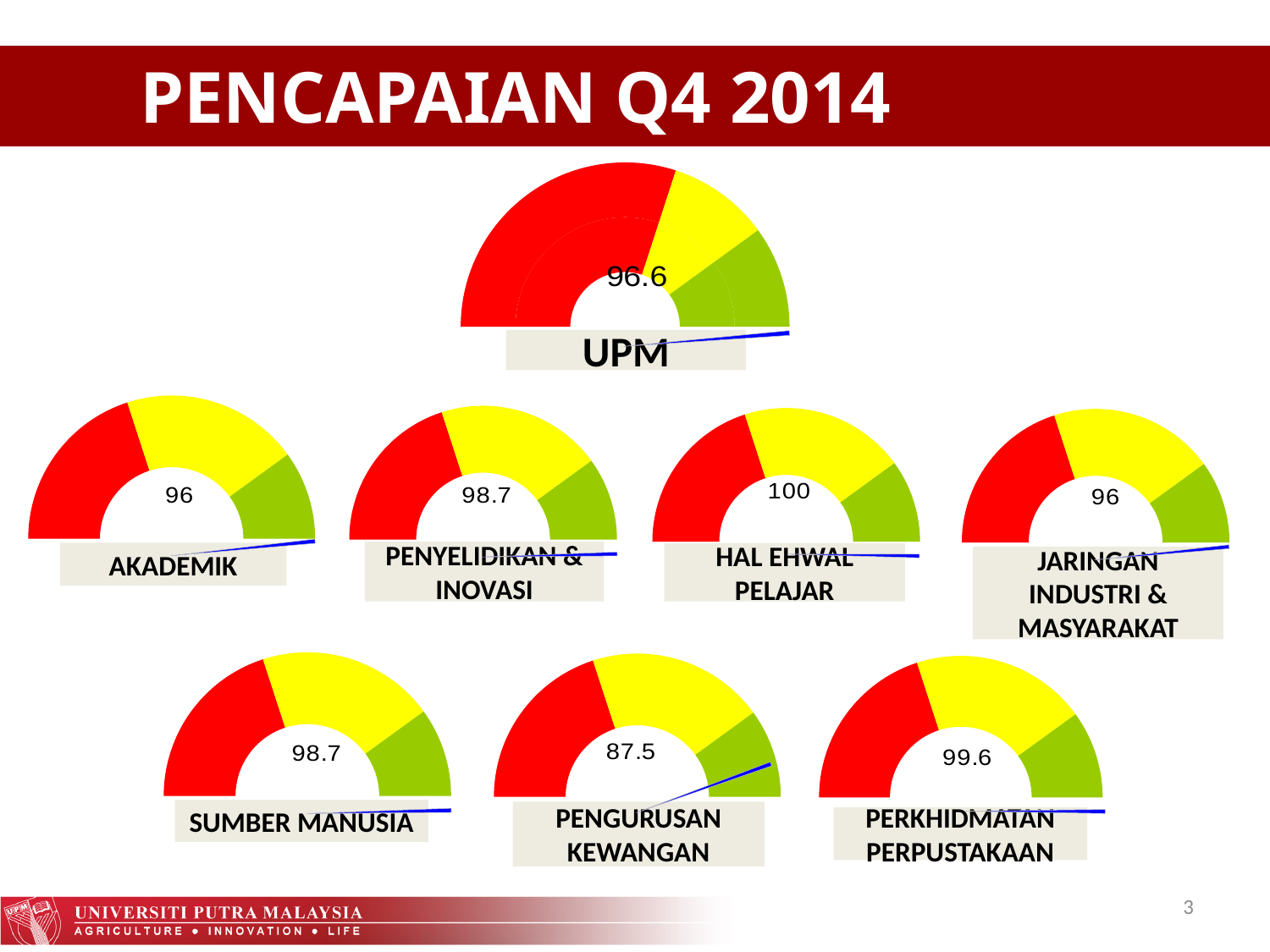
What is the difference between the HAL EHWAL PELAJAR value and the PENGURUSAN KEWANGAN value? 12.5 Which gauge on the slide shows the lowest value? PENGURUSAN KEWANGAN What is the title of the slide? PENCAPAIAN Q4 2014 What value is shown on the PERKHIDMATAN PERPUSTAKAAN gauge? 99.6 What value is shown on the AKADEMIK gauge? 96 What value is shown on the UPM gauge? 96.6 What kind of chart is used to display the values on this slide? Gauge chart Which has the larger value, PERKHIDMATAN PERPUSTAKAAN or SUMBER MANUSIA? PERKHIDMATAN PERPUSTAKAAN How many gauge charts are shown on the slide? 8 What value is shown on the HAL EHWAL PELAJAR gauge? 100 What value is shown on the PENGURUSAN KEWANGAN gauge? 87.5 Which gauge on the slide shows the highest value? HAL EHWAL PELAJAR